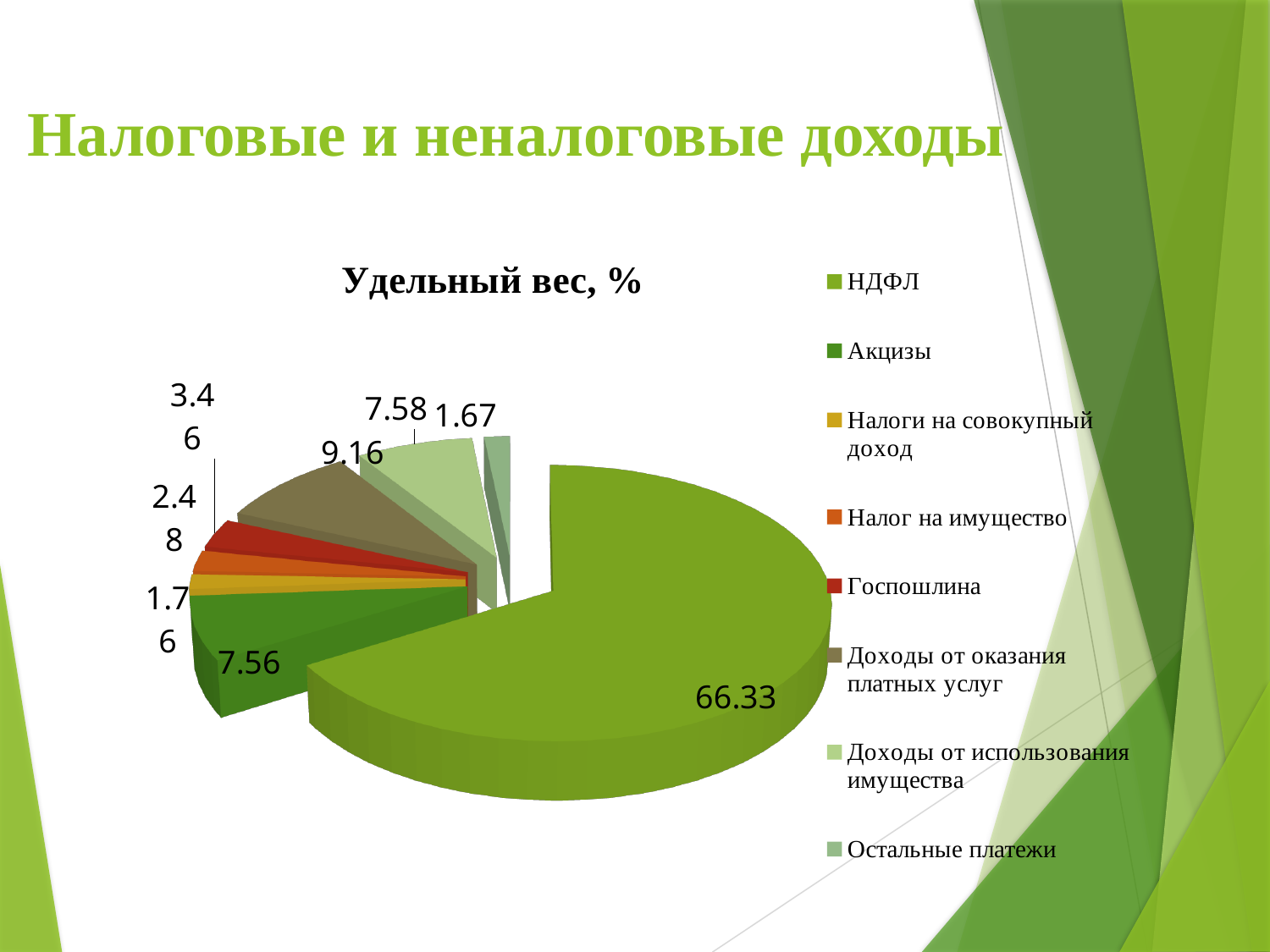
How many categories does the legend list? 8 Which is larger, Госпошлина or Налог на имущество? Госпошлина What is the value for Госпошлина? 3.46 What is the value for Доходы от оказания платных услуг? 9.16 Which category has the smallest share of the pie? Остальные платежи What is the value for Доходы от использования имущества? 7.58 What is the title of the chart? Удельный вес, % What is the value for Акцизы? 7.56 What kind of chart is shown on the slide? pie chart What is the value for Остальные платежи? 1.67 Which category has the largest share of the pie? НДФЛ What is the value for НДФЛ? 66.33